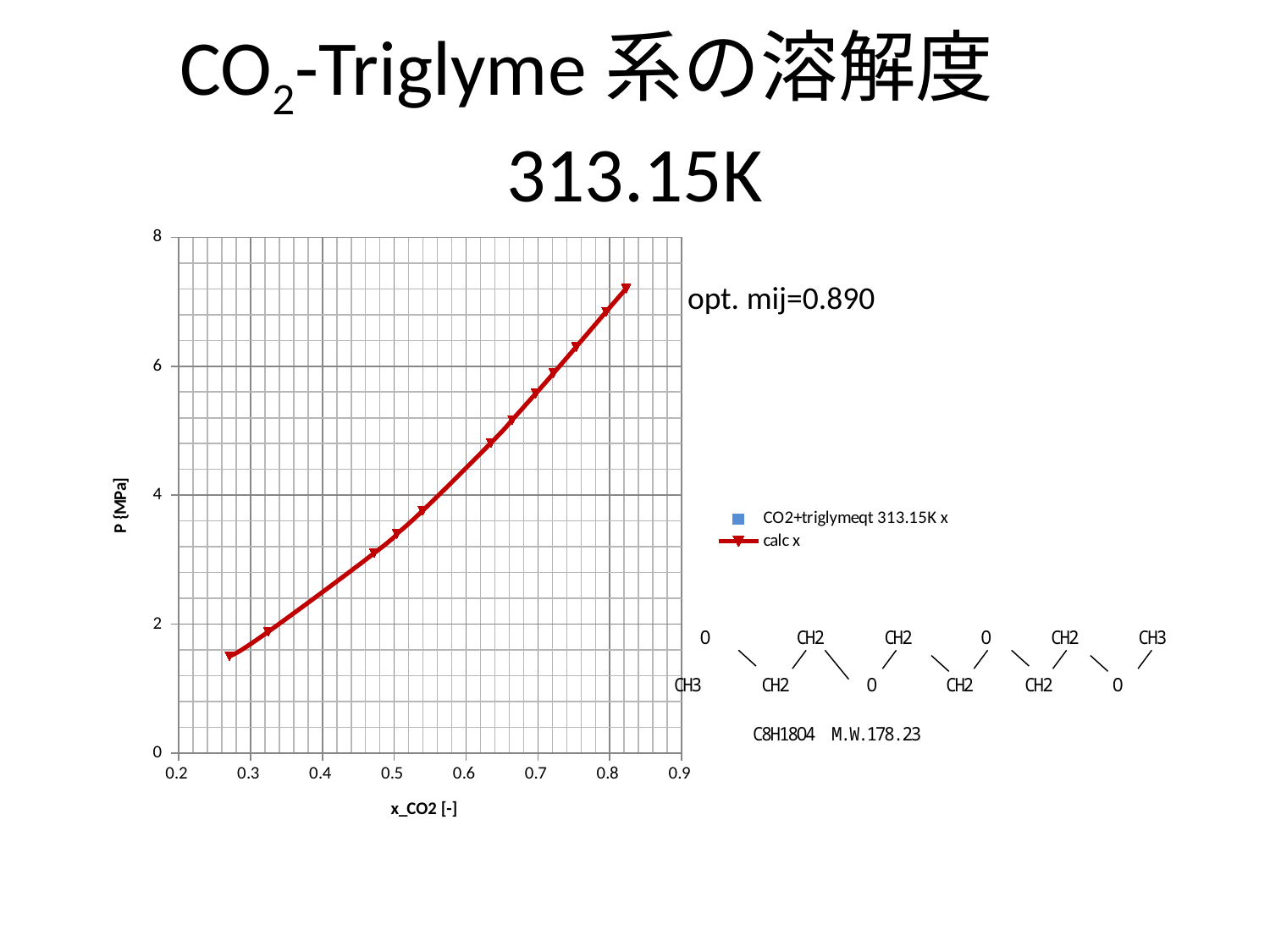
Does the pressure P rise or fall as x_CO2 increases along the x axis? rise Is the value of P for the calc x series at x_CO2 = 0.7 greater or less than 4? greater What kind of chart is shown on the slide? line chart How many series does the legend list? 2 Is the value of P for the calc x series at x_CO2 = 0.5 greater or less than 2? greater What is the label of the y axis? P [MPa] What is the maximum value shown on the y axis? 8 Is the value of P for the calc x series at x_CO2 = 0.5 greater or less than 4? less What are the two series names listed in the legend? CO2+triglymeqt 313.15K x and calc x Which has the larger P value in the calc x series: the point at x_CO2 = 0.3 or the point at x_CO2 = 0.8? the point at x_CO2 = 0.8